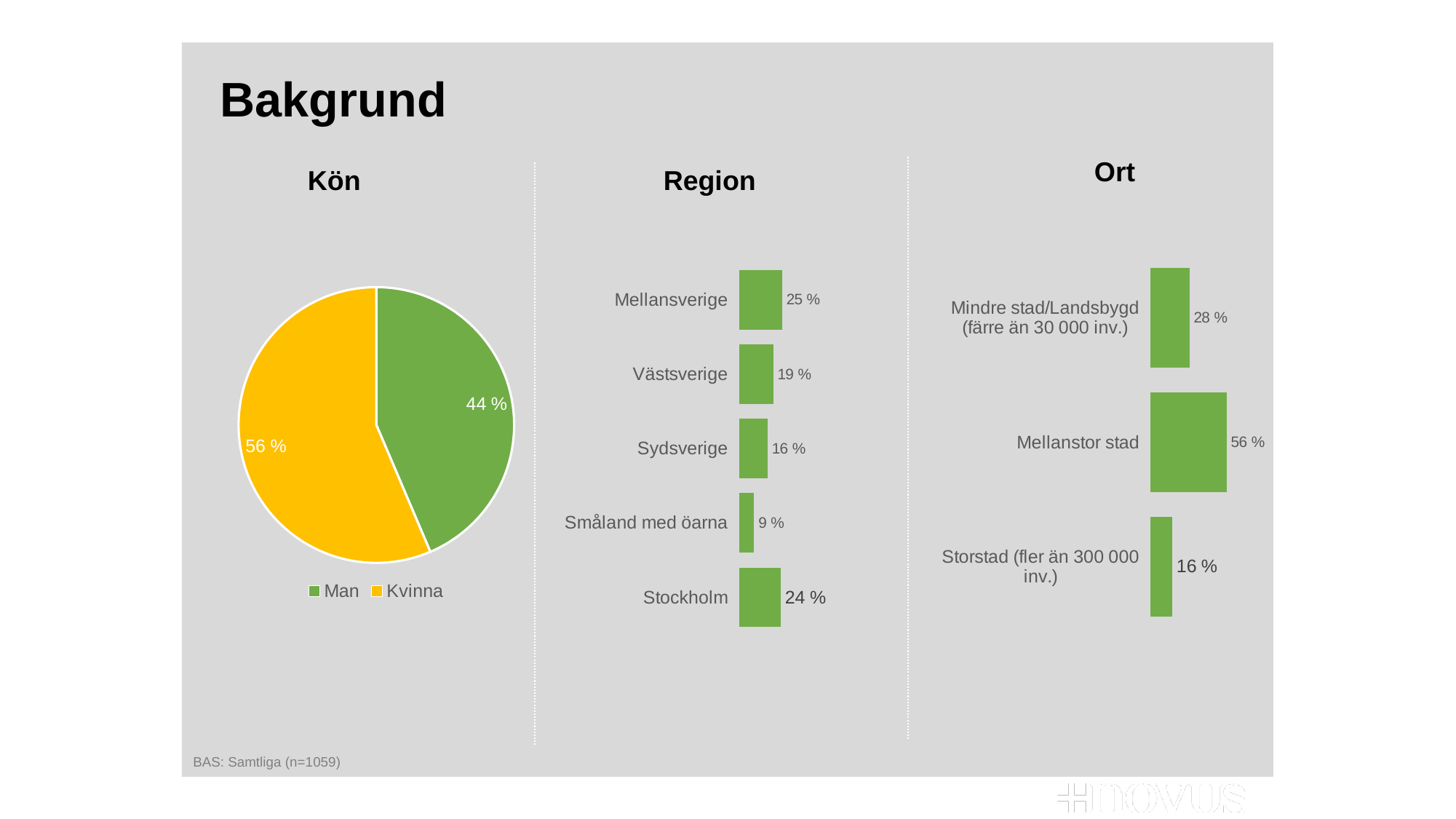
In the Ort chart, which is larger: Mindre stad/Landsbygd or Storstad? Mindre stad/Landsbygd In the Kön chart, what share is labelled for Man? 44 % In the Region chart, what is the value for Västsverige? 19 % How many regions are shown in the Region chart? 5 In the Region chart, which region has the highest value? Mellansverige In the Kön chart, what share is labelled for Kvinna? 56 % How many entries does the legend of the Kön chart list? 2 What kind of chart is the Kön chart? pie chart In the Ort chart, what is the value for Mellanstor stad? 56 % In the Region chart, what is the difference between Mellansverige and Sydsverige? 9 % What kind of chart is the Ort chart? bar chart In the Region chart, which region has the lowest value? Småland med öarna